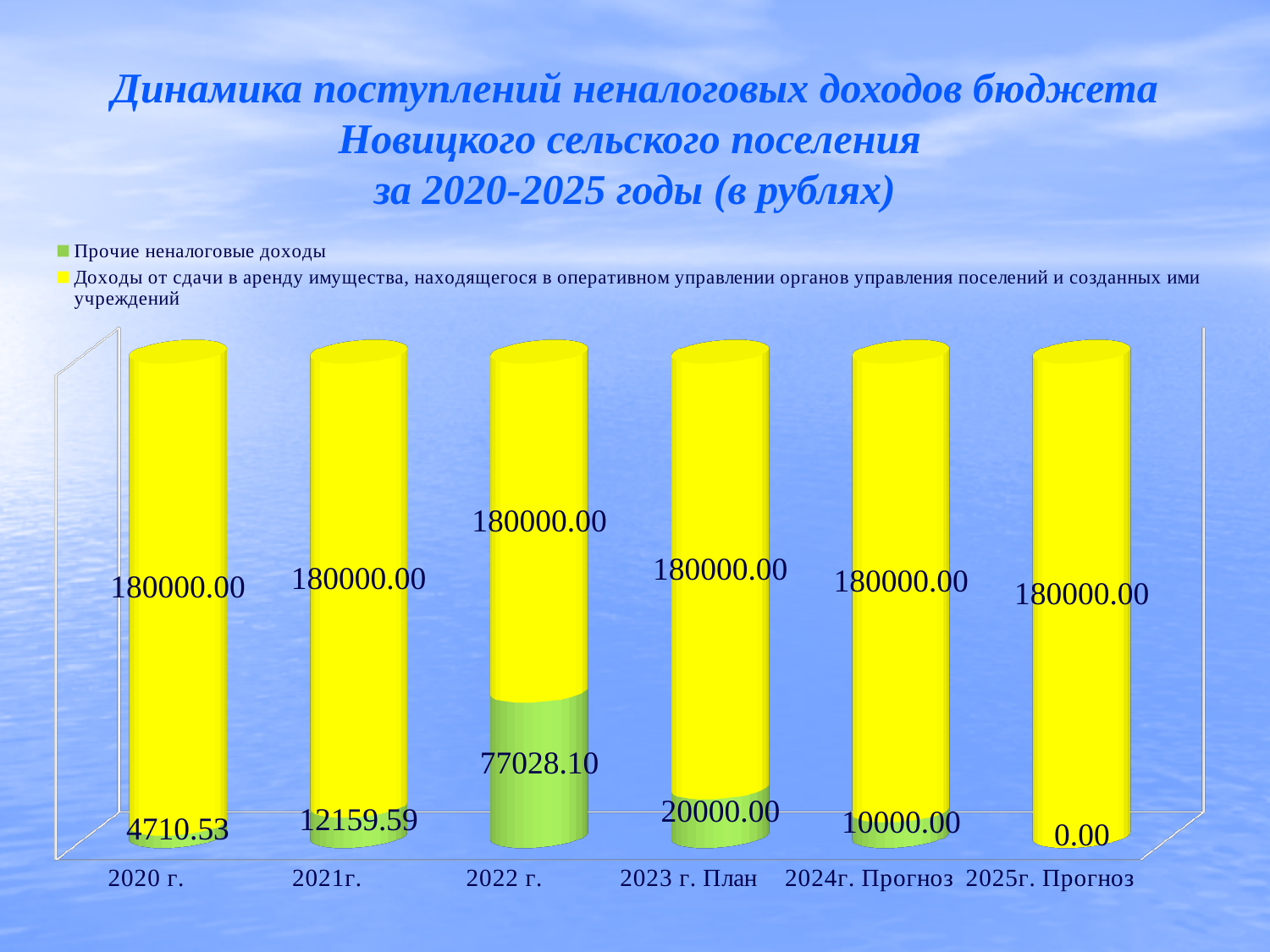
What is the value of Прочие неналоговые доходы for 2022 г.? 77028.10 What is the value of Доходы от сдачи в аренду имущества for 2023 г. План? 180000.00 What is the total of the stacked bar for 2022 г.? 257028.10 In which year is Прочие неналоговые доходы highest? 2022 г. What type of chart is shown on the slide? Stacked bar chart How many categories (years) are shown on the x axis? 6 What is the value of Прочие неналоговые доходы for 2025г. Прогноз? 0.00 Which is larger: Прочие неналоговые доходы in 2021г. or in 2024г. Прогноз? 2021г. How many series does the legend list? 2 In which year is Прочие неналоговые доходы lowest? 2025г. Прогноз What is the value of Прочие неналоговые доходы for 2020 г.? 4710.53 What is the difference between Прочие неналоговые доходы in 2022 г. and 2023 г. План? 57028.10